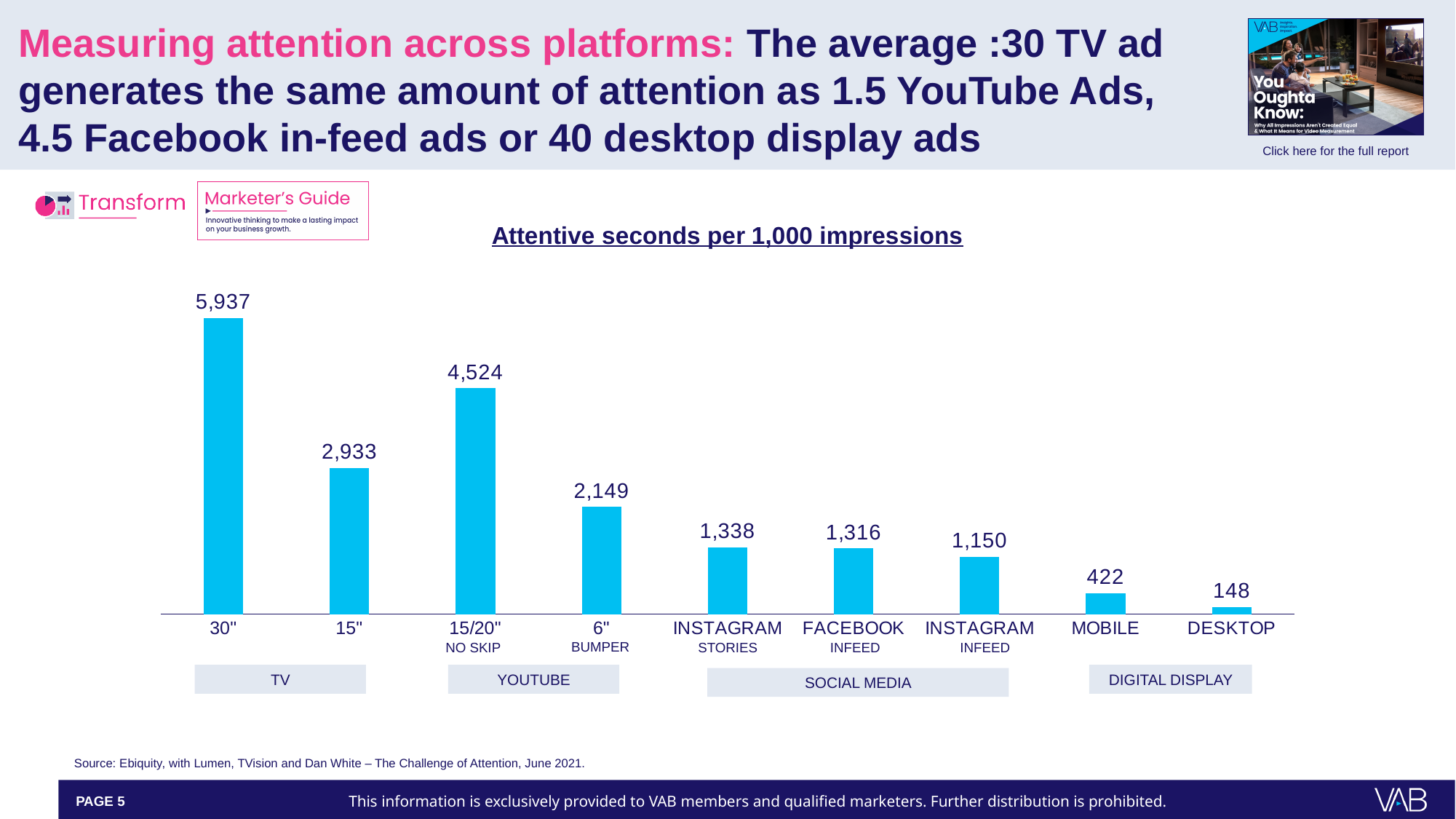
What is the value for Facebook infeed? 1,316 What kind of chart is shown on the slide? Bar chart How many bars are plotted in the chart? 9 Which is larger, the YouTube 15/20" no skip ad or the 15" TV ad? YouTube 15/20" no skip Which category has the lowest attentive seconds per 1,000 impressions? Desktop What is the difference between the 30" TV ad and the 15" TV ad? 3,004 What is the value for the YouTube 6" bumper ad? 2,149 What is the value for the 30" TV ad in the chart? 5,937 Which category has the highest attentive seconds per 1,000 impressions? 30" TV What is the difference between mobile and desktop digital display? 274 What is the value for desktop digital display? 148 What is the title of the chart? Attentive seconds per 1,000 impressions